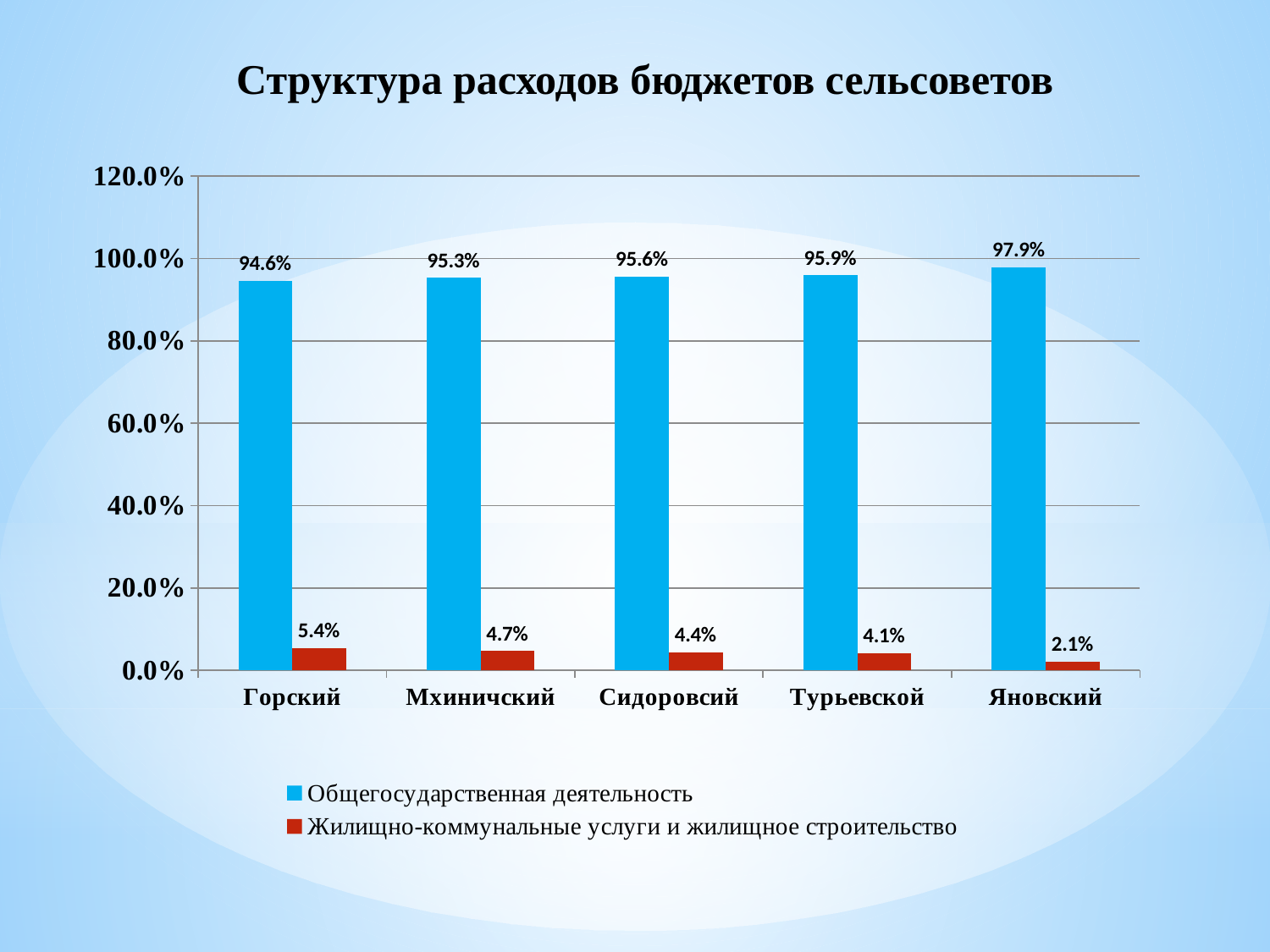
What is the difference between the Общегосударственная деятельность values for Яновский and Горский? 3.3% What is the value of Общегосударственная деятельность for Сидоровсий? 95.6% How many series does the legend list? 2 What is the value of Жилищно-коммунальные услуги и жилищное строительство for Яновский? 2.1% What kind of chart is shown on the slide? Bar chart How many categories are shown on the x axis? 5 Which category has the highest value for Общегосударственная деятельность? Яновский What is the value of Общегосударственная деятельность for Горский? 94.6% Do the values for Общегосударственная деятельность rise or fall from left to right along the x axis? Rise Which is larger: the Жилищно-коммунальные услуги и жилищное строительство value for Горский or for Турьевской? Горский Which category has the lowest value for Жилищно-коммунальные услуги и жилищное строительство? Яновский What is the title of the chart? Структура расходов бюджетов сельсоветов